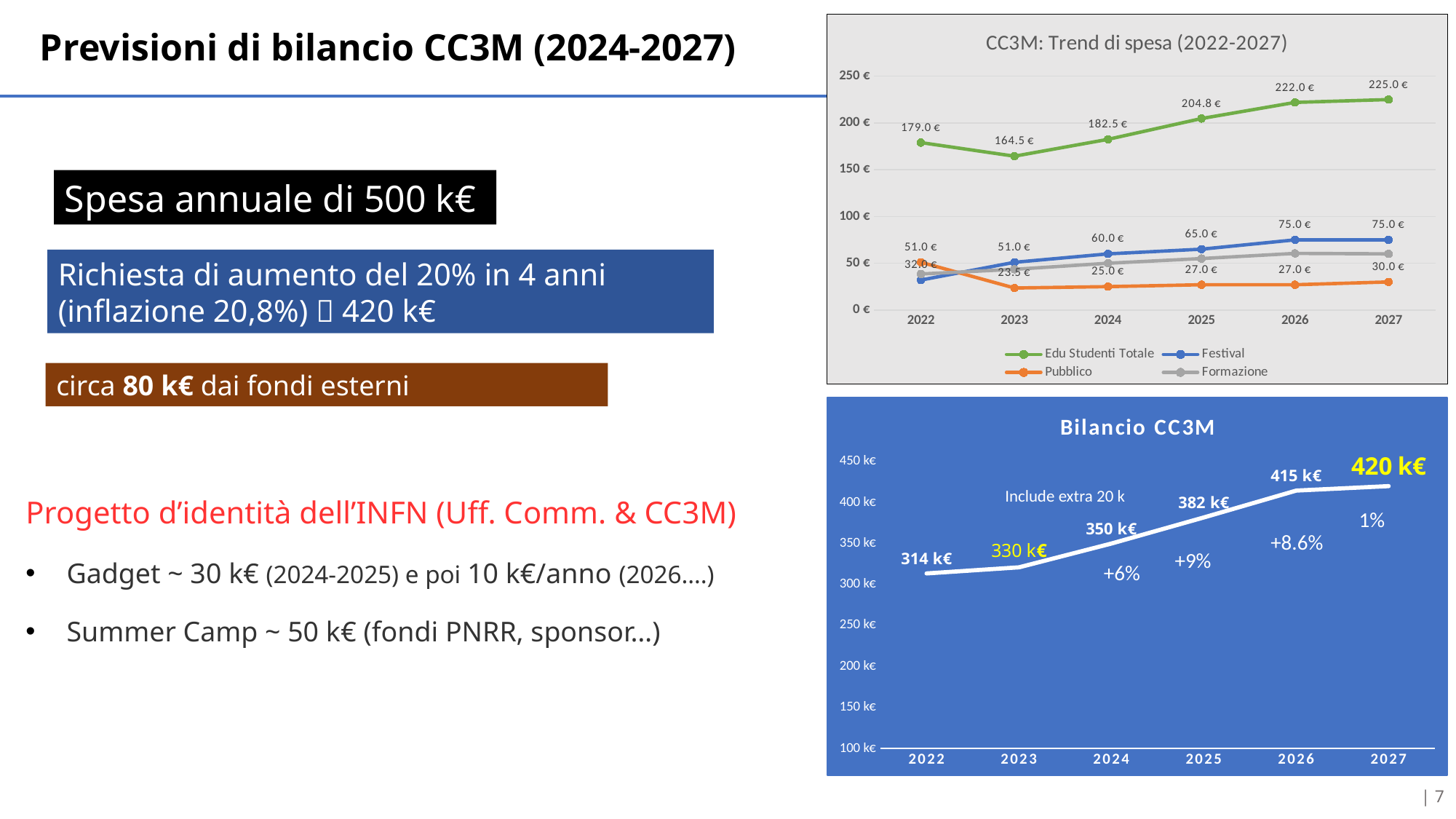
In the chart titled "CC3M: Trend di spesa (2022-2027)", does the Pubblico series rise or fall from 2022 to 2023? Fall In the chart titled "CC3M: Trend di spesa (2022-2027)", what is the value for Edu Studenti Totale in 2025? 204.8 € In the chart titled "CC3M: Trend di spesa (2022-2027)", what is the value for Festival in 2024? 60.0 € In the chart titled "CC3M: Trend di spesa (2022-2027)", which is larger in 2027: Festival or Pubblico? Festival In the chart titled "Bilancio CC3M", what percentage increase is shown between 2025 and 2026? +8.6% In the chart titled "CC3M: Trend di spesa (2022-2027)", what is the difference between the Edu Studenti Totale values for 2027 and 2022? 46.0 € In the chart titled "CC3M: Trend di spesa (2022-2027)", in which year is Edu Studenti Totale lowest? 2023 In the chart titled "CC3M: Trend di spesa (2022-2027)", how many series does the legend list? 4 In the chart titled "CC3M: Trend di spesa (2022-2027)", what kind of chart is it? Line chart In the chart titled "Bilancio CC3M", what is the difference between the values for 2026 and 2025? 33 k€ In the chart titled "Bilancio CC3M", how many years are plotted on the x axis? 6 In the chart titled "Bilancio CC3M", what is the value for 2024? 350 k€